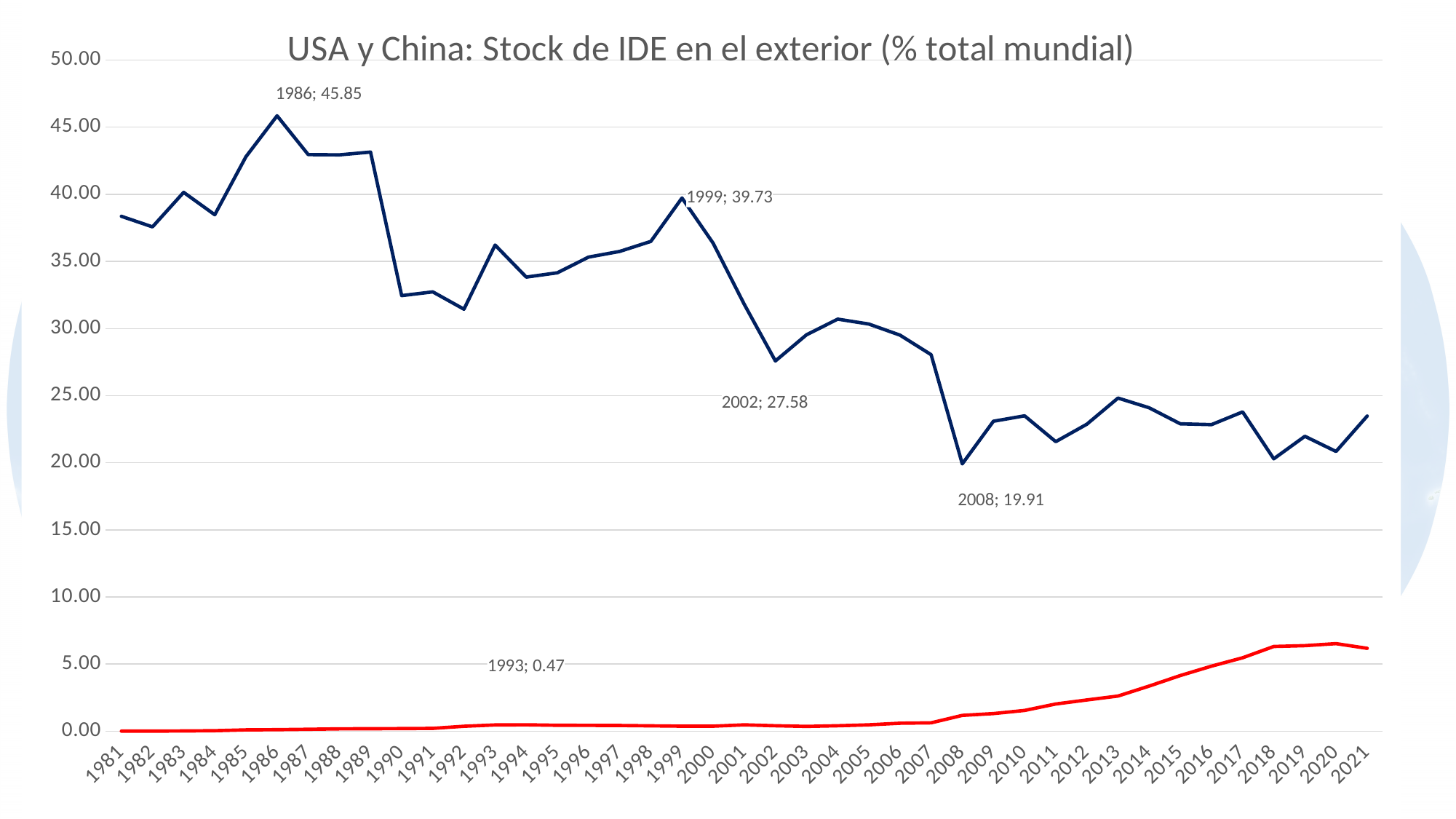
In which year does the dark blue line reach its highest value? 1986 What value is labeled for 1999 on the dark blue line? 39.73 Does the red line generally rise or fall from 1981 to 2021? rise What is the difference between the labeled values for 1999 and 2002 on the dark blue line? 12.15 What is the difference between the labeled values for 1986 and 2008 on the dark blue line? 25.94 Is the value of the dark blue line in 2021 greater or less than 25.00? less What kind of chart is shown on the slide? line chart What value is labeled for 2008 on the dark blue line? 19.91 What value is labeled for 1986 on the dark blue line? 45.85 What is the title of the chart? USA y China: Stock de IDE en el exterior (% total mundial) What value is labeled for 1993 on the red line? 0.47 How many years are shown on the x axis? 41